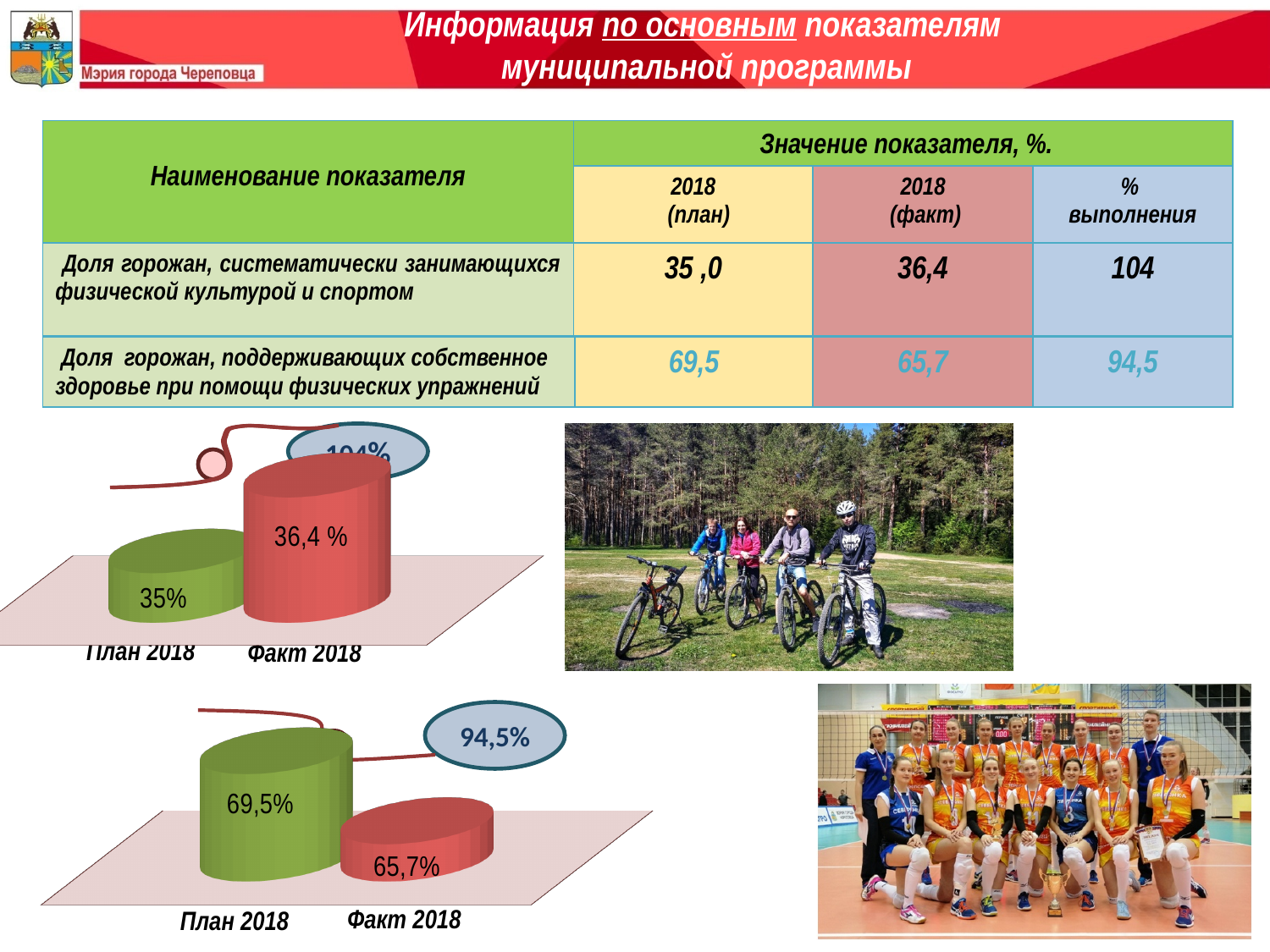
In the lower-left chart, which category has the highest value? План 2018 In the lower-left chart, what percentage is shown in the callout bubble? 94,5% In the upper-left chart, what is the value for План 2018? 35% In the lower-left chart, what is the value for План 2018? 69,5% How many categories are shown in the upper-left chart? 2 In the lower-left chart, which category has the lowest value? Факт 2018 In the lower-left chart, what is the value for Факт 2018? 65,7% In the upper-left chart, which category has the higher value, План 2018 or Факт 2018? Факт 2018 In the upper-left chart, what is the value for Факт 2018? 36,4 % What type of chart is the lower-left chart? Bar chart In the lower-left chart, what colour is the bar for План 2018? Green In the lower-left chart, what is the difference between the План 2018 and Факт 2018 values? 3,8